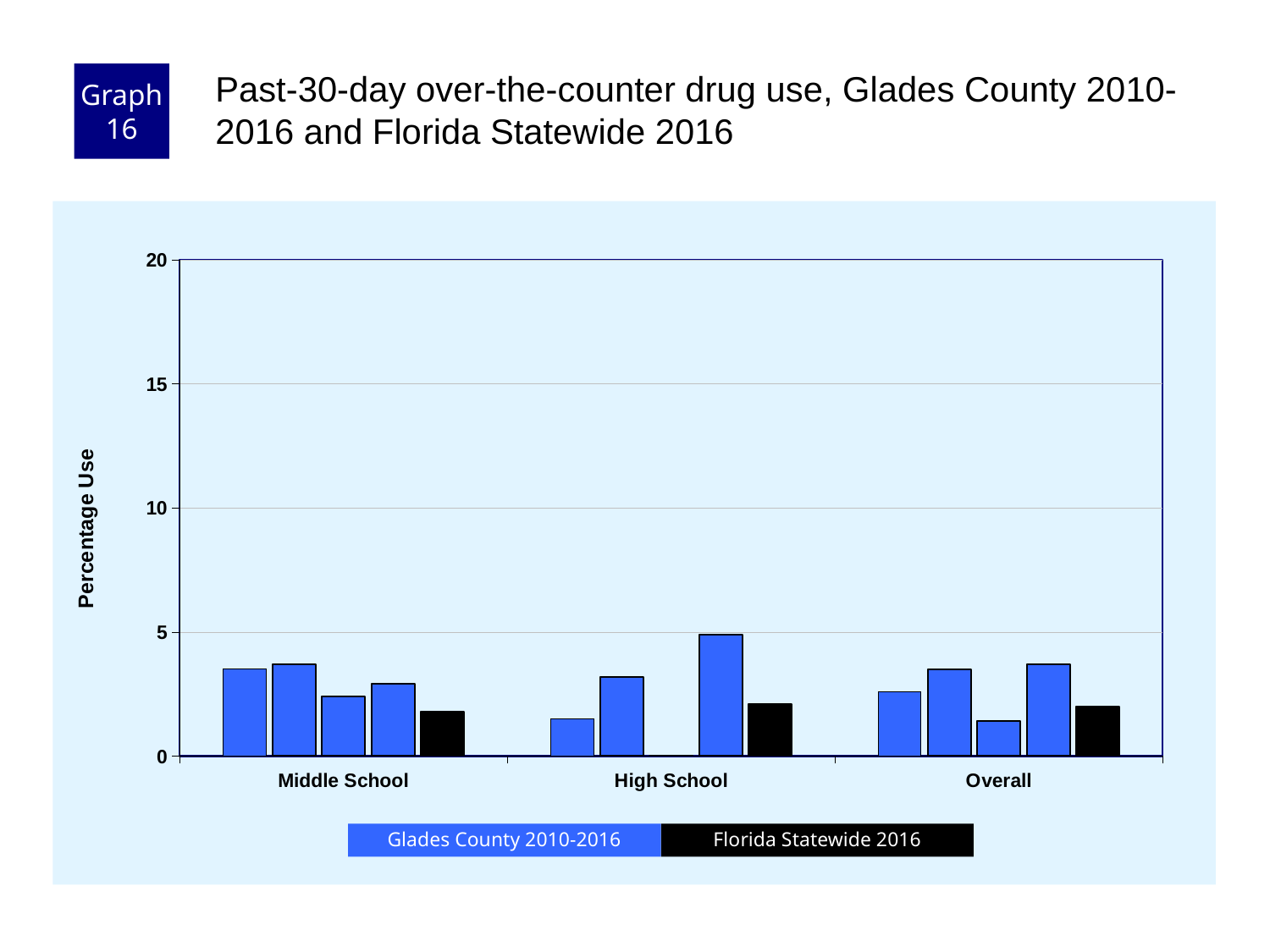
What is the highest value shown on the y axis? 20 Is the Florida Statewide 2016 value for Middle School greater or less than 5? less What kind of chart is shown on the slide? bar chart Is the tallest Glades County 2010-2016 bar for High School greater or less than 10? less Is any bar on the chart greater than 10? no How many series does the legend list? 2 Which colour represents Florida Statewide 2016 in the legend? black Which category contains the tallest bar on the chart? High School What is the label of the y axis? Percentage Use How many categories are shown on the x axis? 3